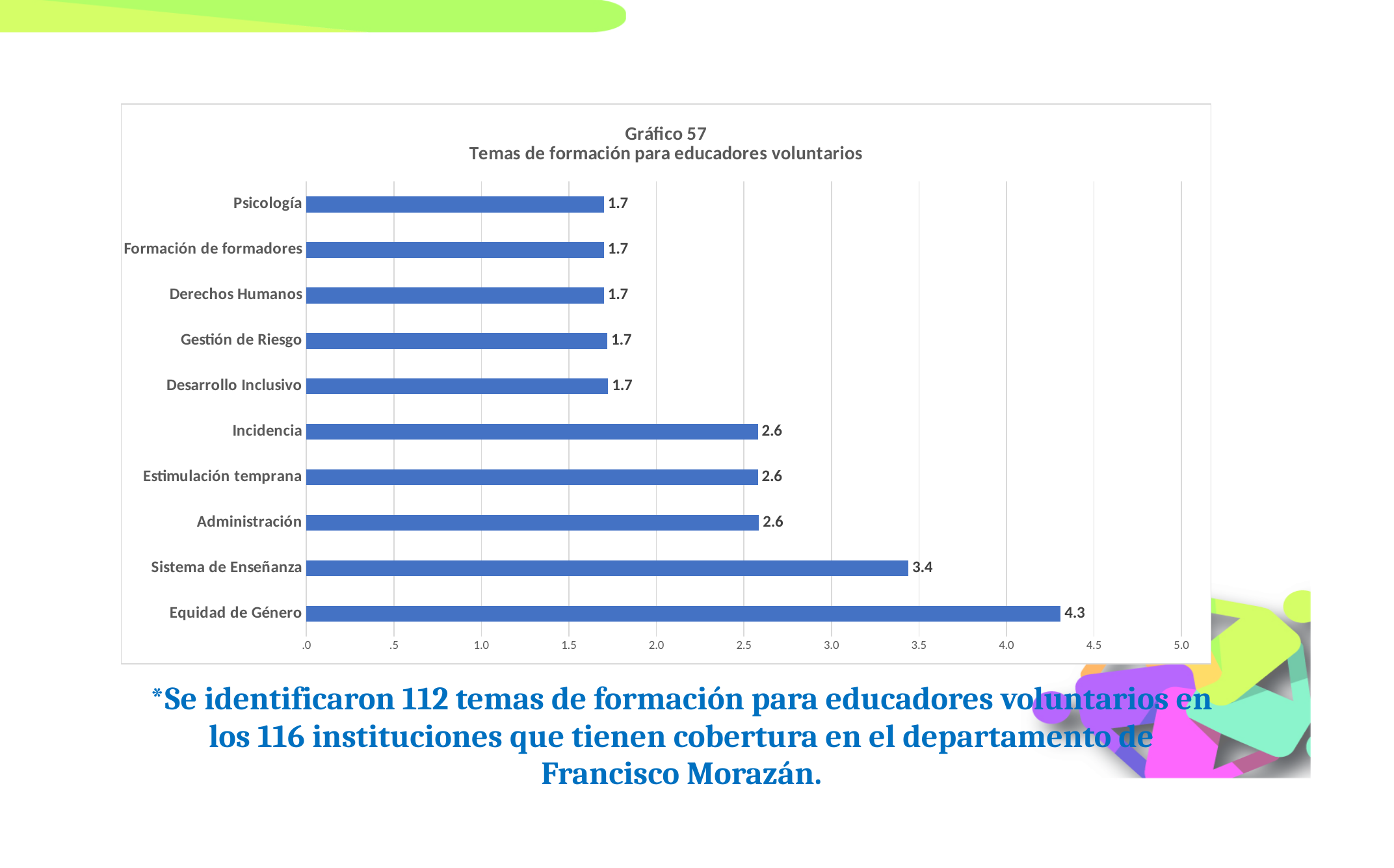
Which is larger, the value for Sistema de Enseñanza or the value for Estimulación temprana? Sistema de Enseñanza What is the difference between the values for Administración and Derechos Humanos? 0.9 What is the value for Equidad de Género? 4.3 What is the difference between the values for Equidad de Género and Sistema de Enseñanza? 0.9 What kind of chart is shown on the slide? bar chart How many categories are shown in the chart? 10 What is the value for Psicología? 1.7 Which category has the highest value? Equidad de Género What is the value for Sistema de Enseñanza? 3.4 What is the value for Incidencia? 2.6 What is the title of the chart? Gráfico 57 Temas de formación para educadores voluntarios Is the value for Equidad de Género greater or less than 4.0? greater